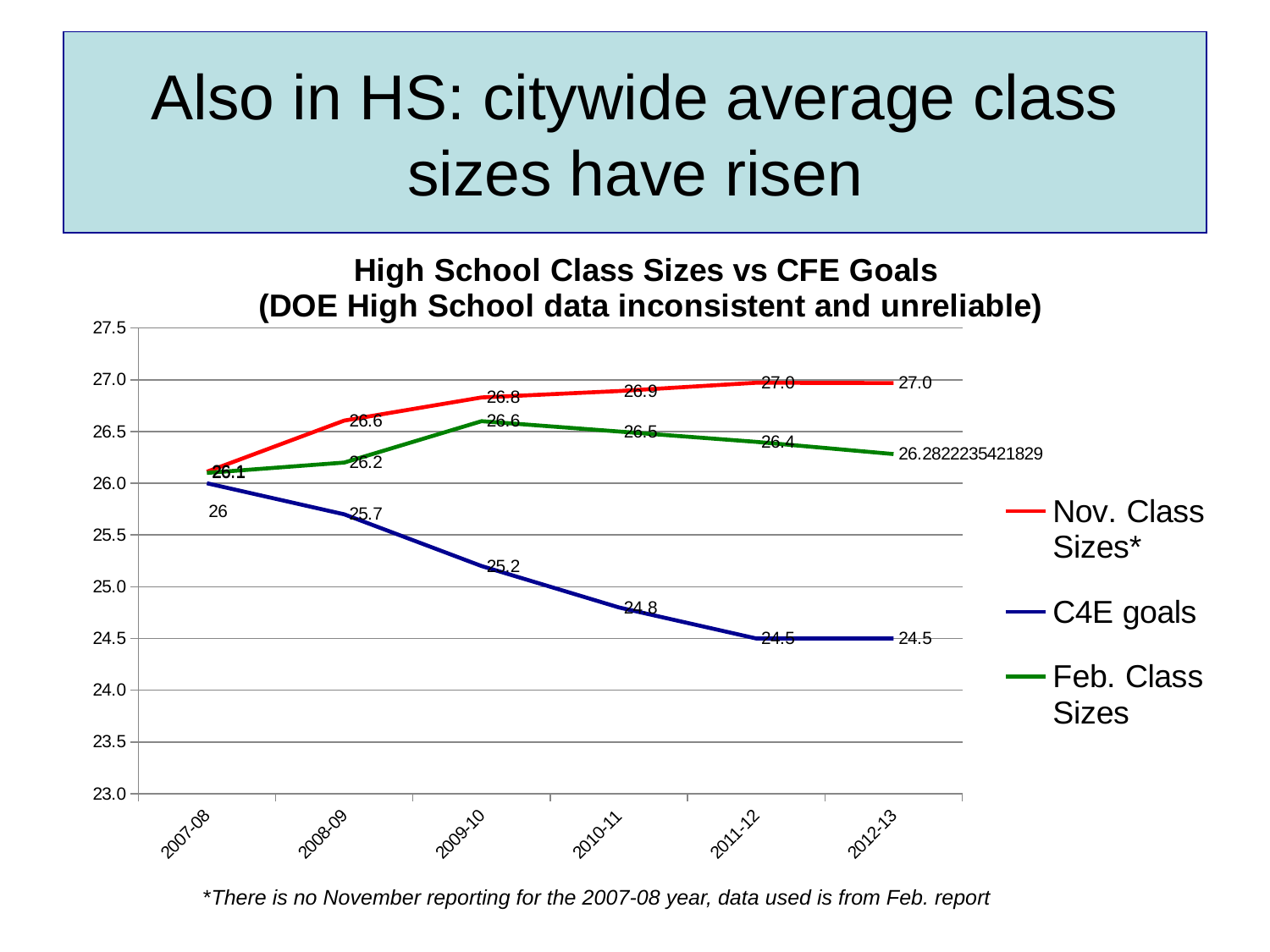
Do the C4E goals rise or fall from 2007-08 to 2012-13? fall Is the Feb. Class Sizes value for 2012-13 greater or less than 26.5? less What is the Nov. Class Sizes value for 2012-13? 27.0 What is the C4E goals value for 2009-10? 25.2 What kind of chart is shown on the slide? line chart What is the difference between the Nov. Class Sizes value and the C4E goals value in 2012-13? 2.5 How many series does the legend list? 3 What is the Feb. Class Sizes value for 2011-12? 26.4 How many school years are plotted along the x axis? 6 In 2010-11, which is larger: Nov. Class Sizes or Feb. Class Sizes? Nov. Class Sizes Do the Nov. Class Sizes rise or fall from 2007-08 to 2012-13? rise In which year is the C4E goals value highest? 2007-08